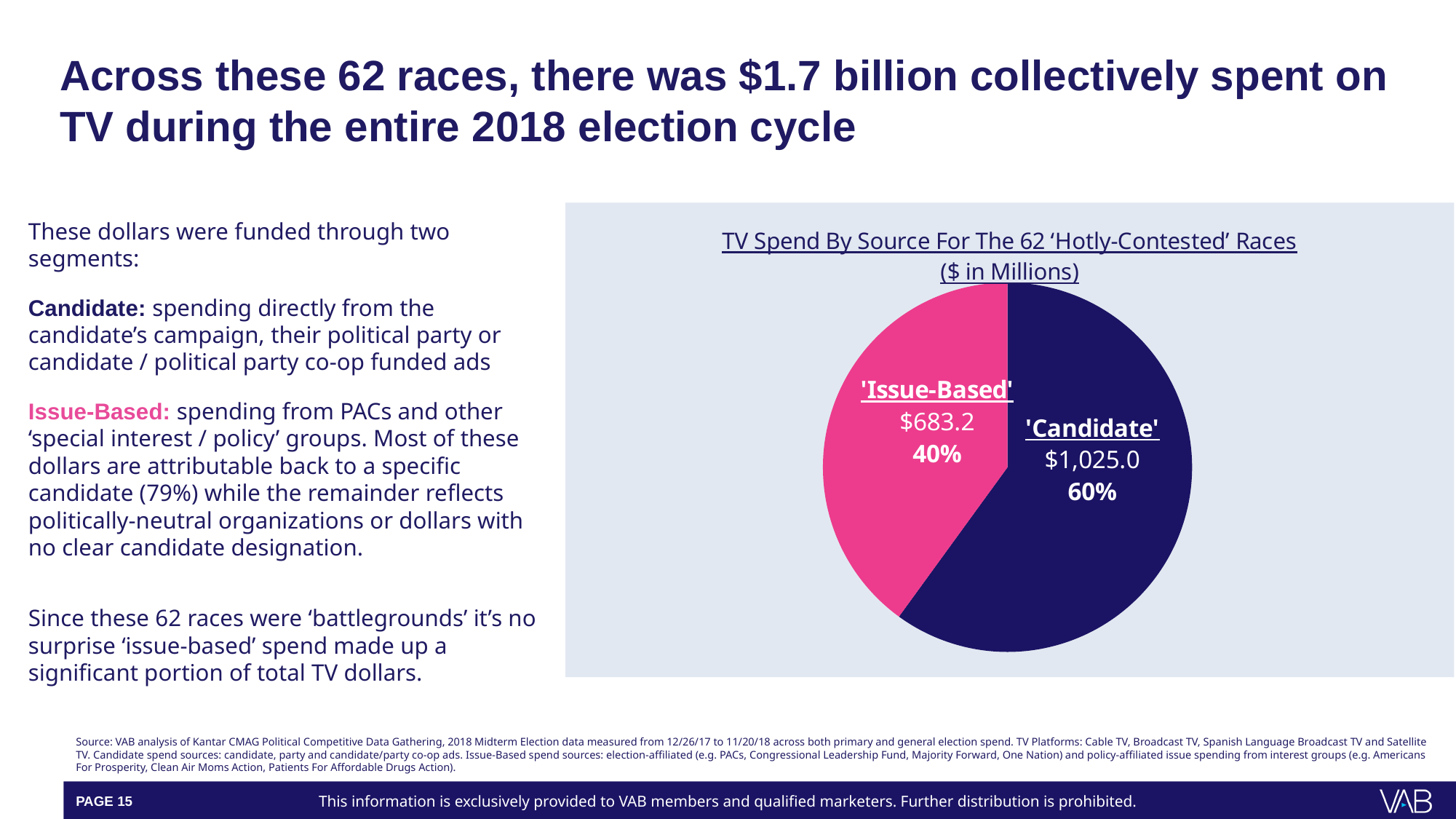
What is the title of the pie chart? TV Spend By Source For The 62 'Hotly-Contested' Races ($ in Millions) What share of the pie does the 'Candidate' slice represent? 60% What is the difference in spend between 'Candidate' and 'Issue-Based'? $341.8 What is the TV spend value for the 'Issue-Based' slice? $683.2 What colour is the 'Issue-Based' slice? Pink How many slices does the pie chart have? 2 Which source has the largest TV spend? 'Candidate' What is the TV spend value for the 'Candidate' slice? $1,025.0 Which is larger, the 'Candidate' spend or the 'Issue-Based' spend? 'Candidate' What share of the pie does the 'Issue-Based' slice represent? 40% What kind of chart is shown on the slide? Pie chart Which source has the smallest TV spend? 'Issue-Based'